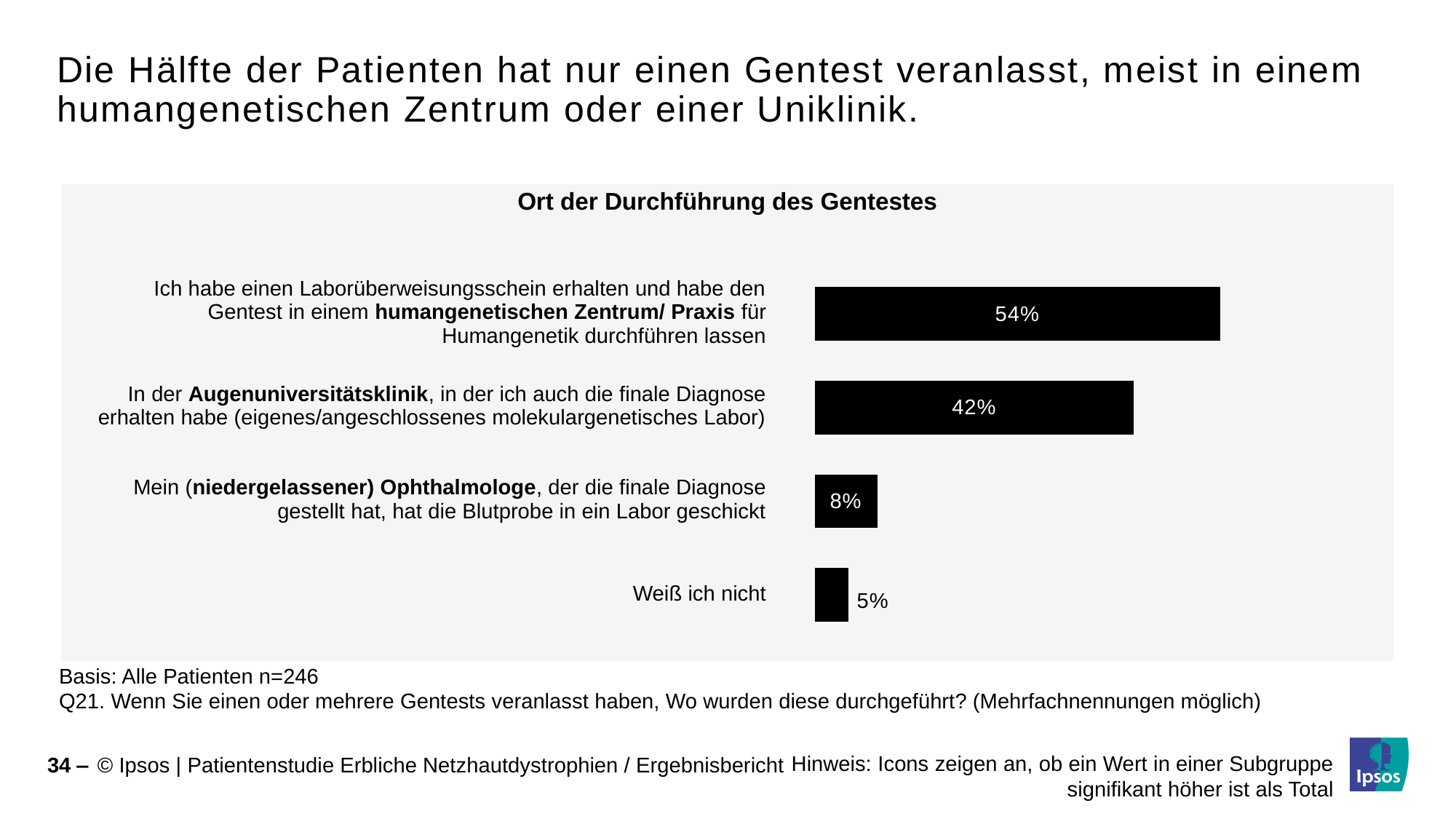
Which category has the highest value? Humangenetisches Zentrum/ Praxis für Humangenetik Which category has the lowest value? Weiß ich nicht Which is larger: the value for Augenuniversitätsklinik or for niedergelassener Ophthalmologe? Augenuniversitätsklinik How many categories are shown in the chart? 4 What type of chart is shown on the slide? Bar chart What percentage corresponds to the niedergelassener Ophthalmologe sending the blood sample to a lab? 8% What is the value for 'Weiß ich nicht'? 5% What is the value for the Augenuniversitätsklinik category? 42% What percentage of patients had the genetic test done in a humangenetisches Zentrum/ Praxis für Humangenetik? 54% What is the title of the chart? Ort der Durchführung des Gentestes What is the difference between the humangenetisches Zentrum value and the Augenuniversitätsklinik value? 12 percentage points What is the difference between the niedergelassener Ophthalmologe value and the 'Weiß ich nicht' value? 3 percentage points